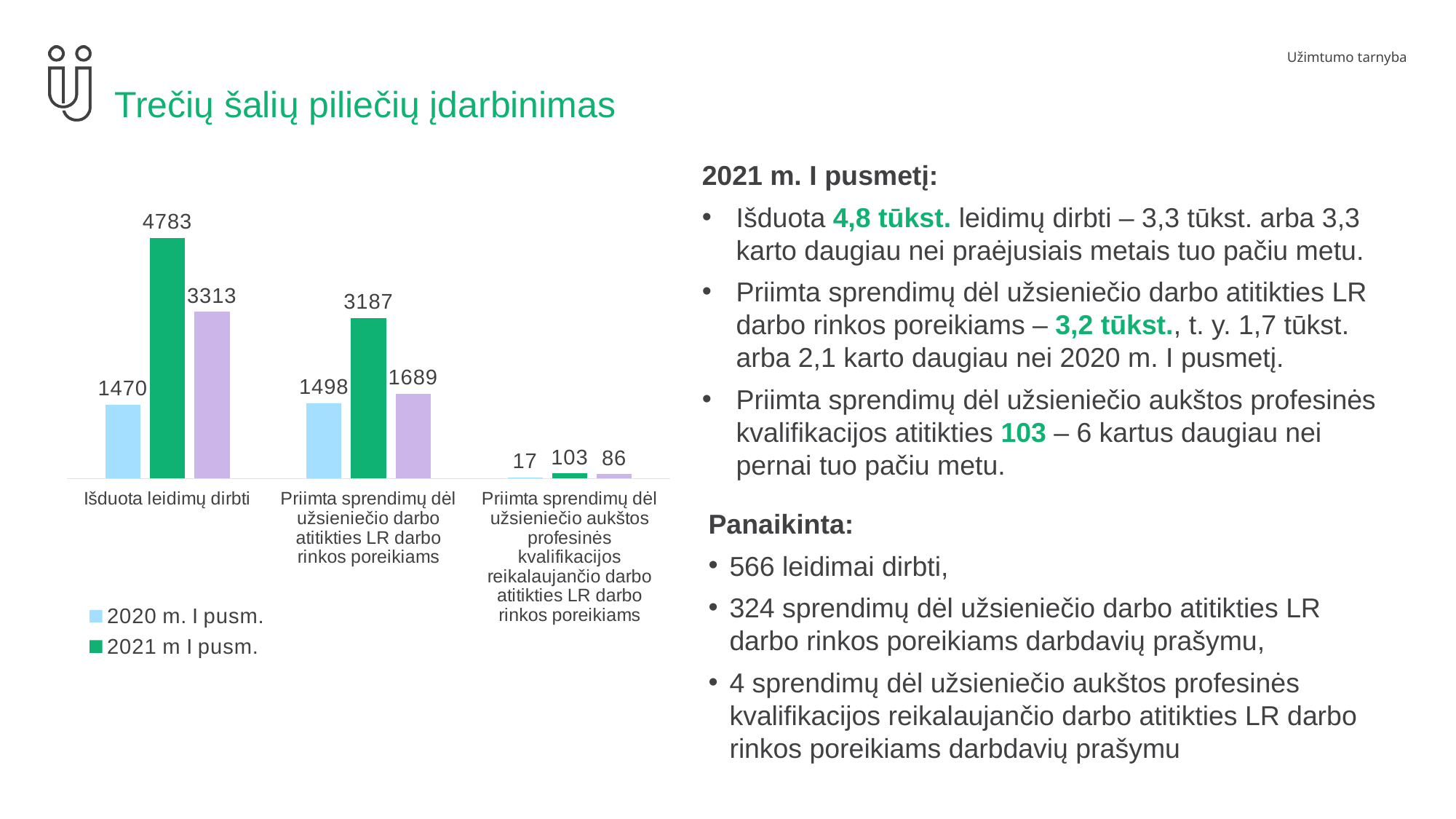
What is the value for 'Išduota leidimų dirbti' in the '2021 m I pusm.' series? 4783 How many series does the chart legend list? 2 How many categories are shown on the x axis of the chart? 3 What is the '2020 m. I pusm.' value for 'Priimta sprendimų dėl užsieniečio aukštos profesinės kvalifikacijos reikalaujančio darbo atitikties LR darbo rinkos poreikiams'? 17 Which category has the highest '2021 m I pusm.' value? Išduota leidimų dirbti What is the difference between the '2021 m I pusm.' and '2020 m. I pusm.' values for 'Priimta sprendimų dėl užsieniečio darbo atitikties LR darbo rinkos poreikiams'? 1689 What is the '2021 m I pusm.' value for 'Priimta sprendimų dėl užsieniečio darbo atitikties LR darbo rinkos poreikiams'? 3187 Which category has the lowest '2020 m. I pusm.' value? Priimta sprendimų dėl užsieniečio aukštos profesinės kvalifikacijos reikalaujančio darbo atitikties LR darbo rinkos poreikiams What is the value for 'Išduota leidimų dirbti' in the '2020 m. I pusm.' series? 1470 What kind of chart is shown on the slide? Bar chart Which is larger: the '2020 m. I pusm.' value for 'Išduota leidimų dirbti' or the '2020 m. I pusm.' value for 'Priimta sprendimų dėl užsieniečio darbo atitikties LR darbo rinkos poreikiams'? Priimta sprendimų dėl užsieniečio darbo atitikties LR darbo rinkos poreikiams What is the difference between the '2021 m I pusm.' and '2020 m. I pusm.' values for 'Išduota leidimų dirbti'? 3313